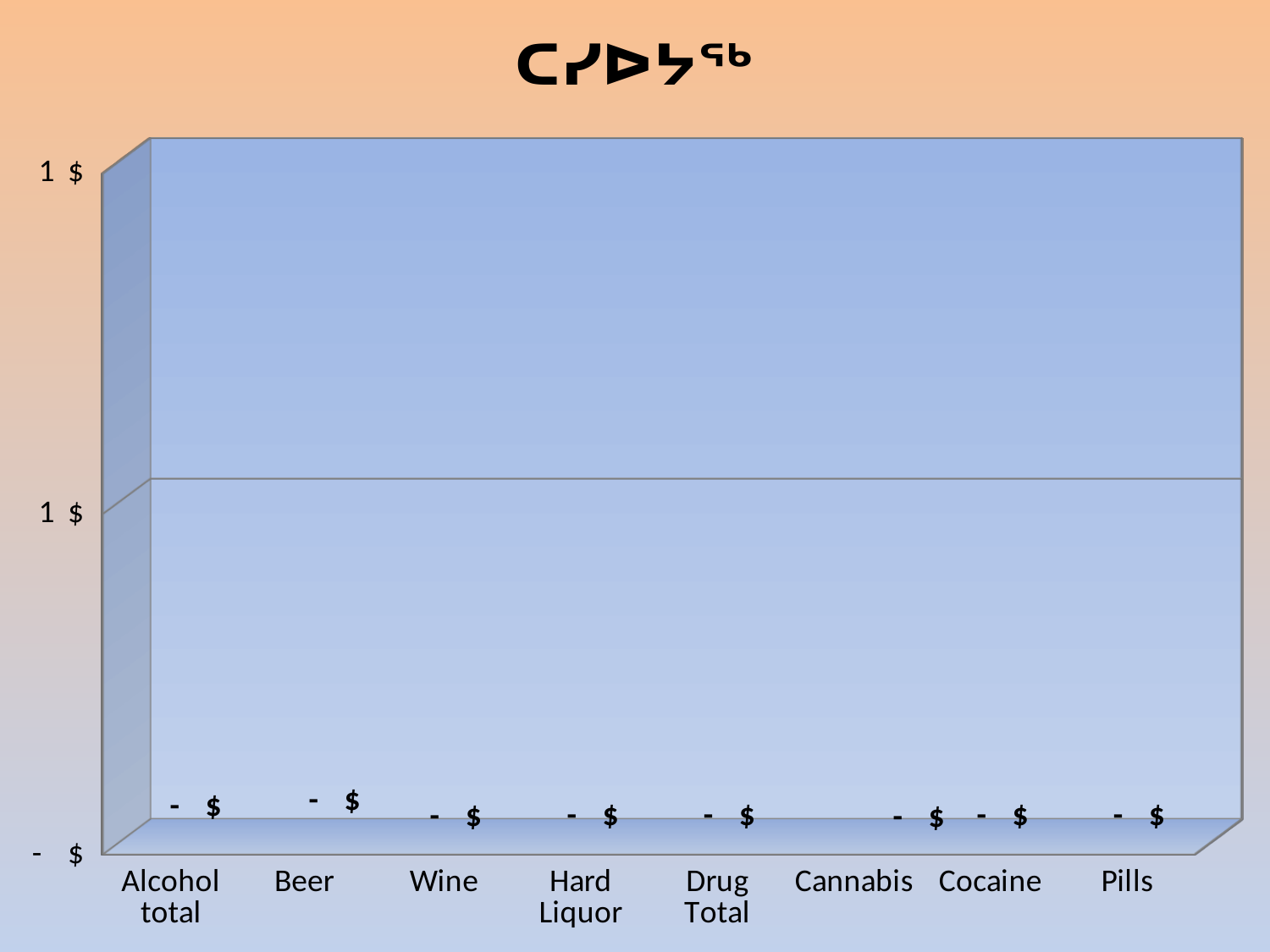
What is the data label shown for Cannabis? - $ What is the label of the last category on the x axis? Pills How many categories are shown on the x axis of the chart? 8 What kind of chart is shown on the slide? bar chart What is the label of the first category on the x axis? Alcohol total What is the data label shown for Pills? - $ What is the data label shown for Beer? - $ What is the data label shown for Alcohol total? - $